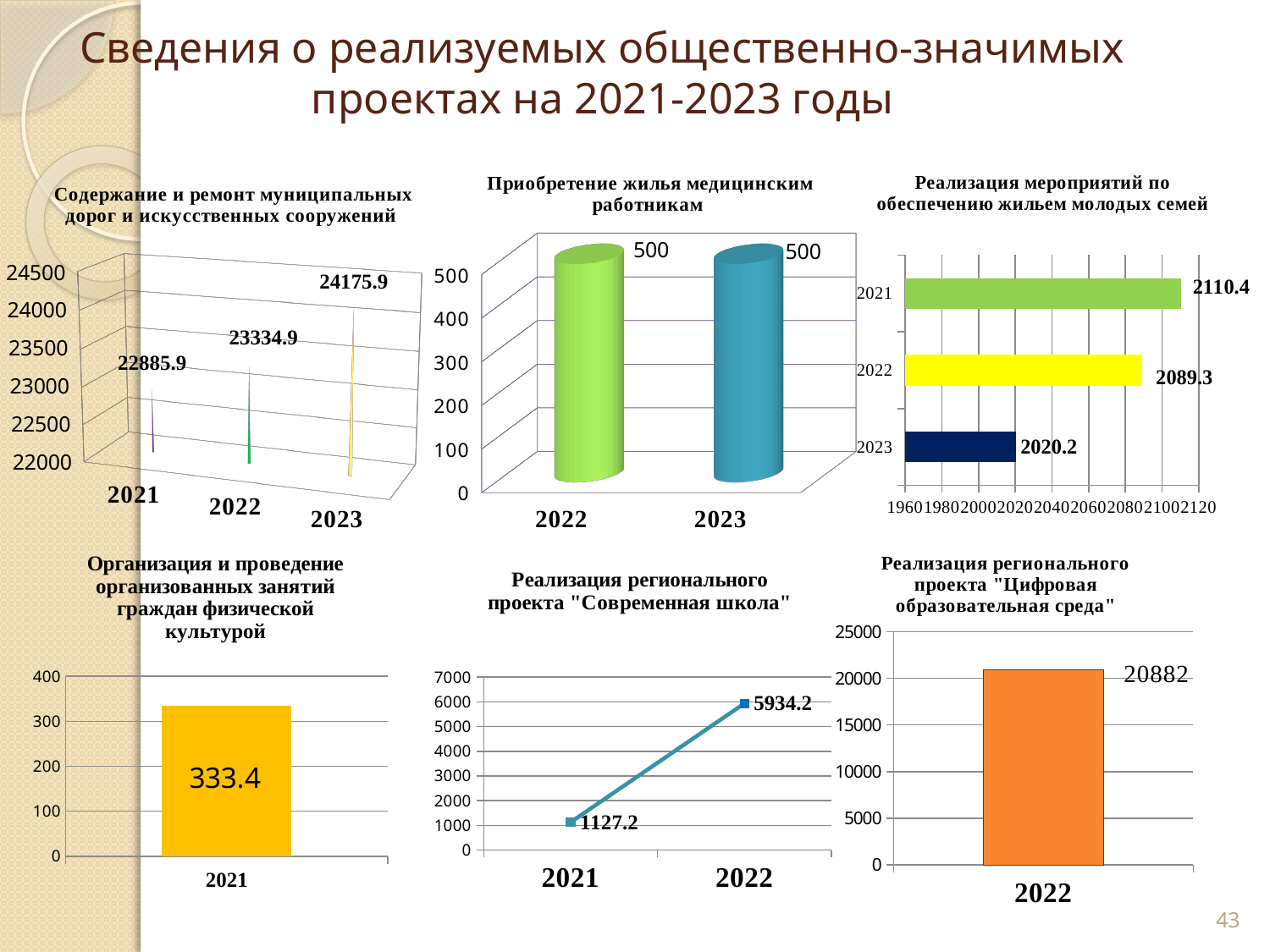
In the chart titled "Содержание и ремонт муниципальных дорог и искусственных сооружений", do the values rise or fall from 2021 to 2023? rise In the chart titled "Реализация регионального проекта "Цифровая образовательная среда"", what is the value for 2022? 20882 In the chart titled "Содержание и ремонт муниципальных дорог и искусственных сооружений", what is the value for 2023? 24175.9 In the chart titled "Реализация мероприятий по обеспечению жильем молодых семей", what is the difference between the 2021 and 2023 values? 90.2 In the chart titled "Приобретение жилья медицинским работникам", what is the value for 2022? 500 In the chart titled "Реализация регионального проекта "Современная школа"", what is the difference between the 2022 and 2021 values? 4807.0 In the chart titled "Организация и проведение организованных занятий граждан физической культурой", what is the value for 2021? 333.4 What kind of chart is the one titled "Реализация регионального проекта "Современная школа""? line chart In the chart titled "Реализация мероприятий по обеспечению жильем молодых семей", which year has the highest value? 2021 In the chart titled "Содержание и ремонт муниципальных дорог и искусственных сооружений", which year has the lowest value? 2021 In the chart titled "Реализация мероприятий по обеспечению жильем молодых семей", what is the value for 2022? 2089.3 In the chart titled "Приобретение жилья медицинским работникам", how many years are shown? 2